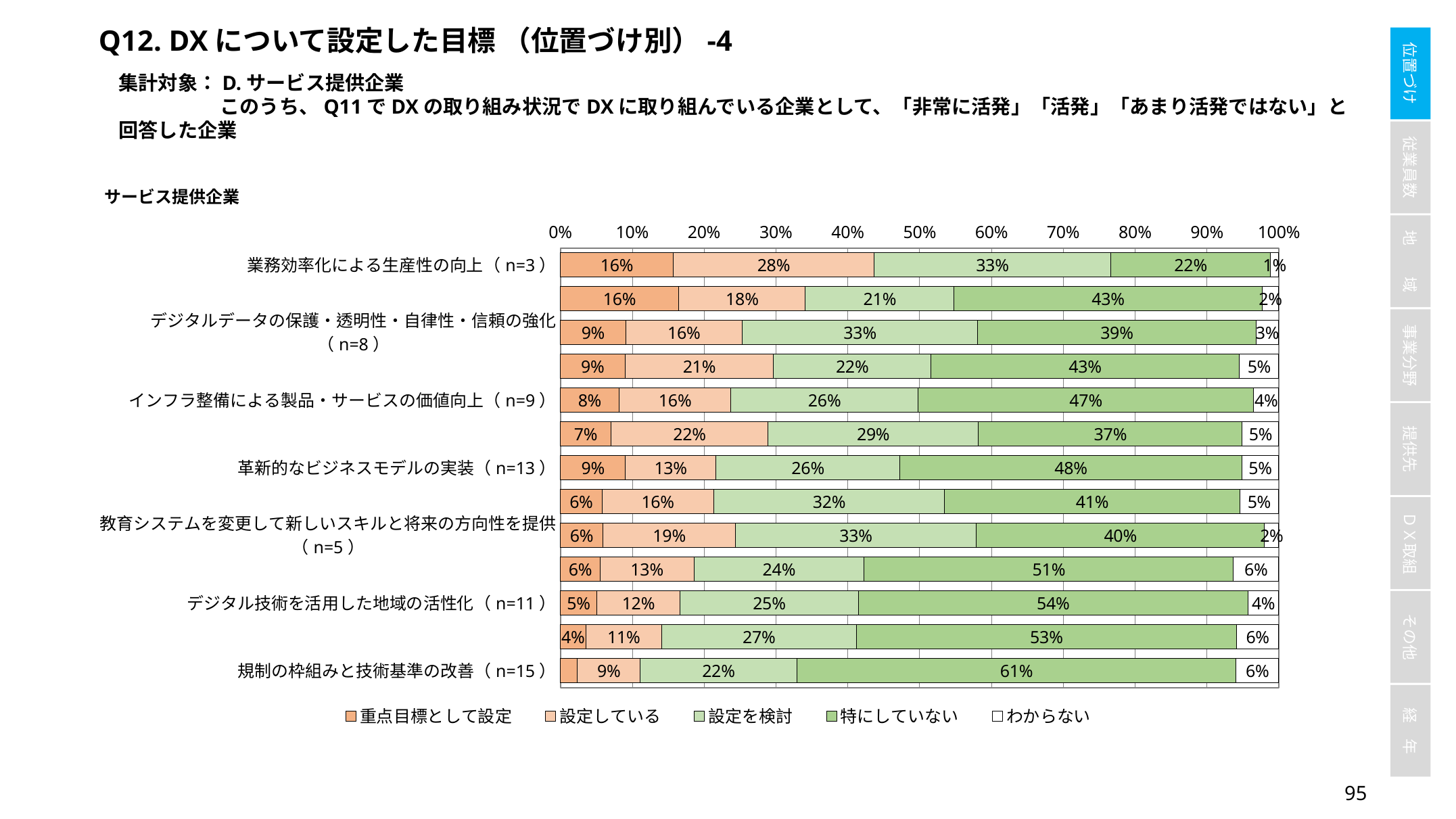
Which is larger for 特にしていない: 業務効率化による生産性の向上（n=3） or 規制の枠組みと技術基準の改善（n=15）? 規制の枠組みと技術基準の改善（n=15） What is the value of 重点目標として設定 for 業務効率化による生産性の向上（n=3）? 16% What is the value of 特にしていない for 規制の枠組みと技術基準の改善（n=15）? 61% How many series does the legend list? 5 What is the value of 設定を検討 for 革新的なビジネスモデルの実装（n=13）? 26% What kind of chart is shown on the slide? Stacked bar chart For 業務効率化による生産性の向上（n=3）, what is the difference between 設定している and 重点目標として設定? 12 percentage points What is the value of 重点目標として設定 for インフラ整備による製品・サービスの価値向上（n=9）? 8% What is the value of わからない for 教育システムを変更して新しいスキルと将来の方向性を提供（n=5）? 2% What is the value of 設定している for デジタル技術を活用した地域の活性化（n=11）? 12% How many bars are plotted in the chart? 13 Which category has the highest value for 特にしていない? 規制の枠組みと技術基準の改善（n=15）